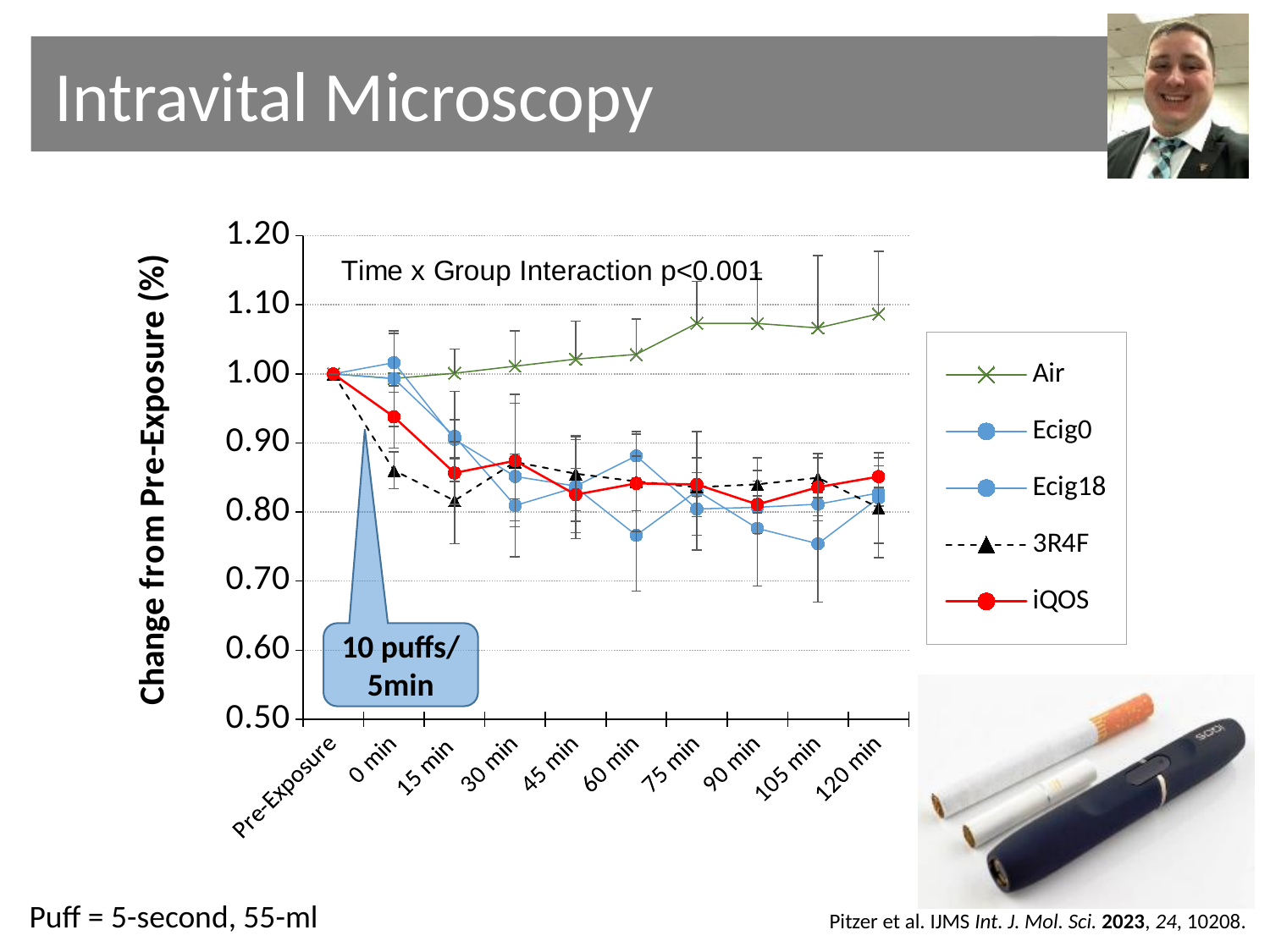
Which series has the highest value at 120 min? Air Is the value for Air at 120 min greater or less than 1.00? greater How many time points are shown along the x axis? 10 What is the value for Air at Pre-Exposure? 1.00 What kind of chart is shown on the slide? line chart What is the title of the y axis? Change from Pre-Exposure (%) Does the Air series generally rise or fall from Pre-Exposure to 120 min? rise At 105 min, which is larger, the value for Air or the value for 3R4F? Air Is the value for 3R4F at 15 min greater or less than 0.90? less How many series does the legend list? 5